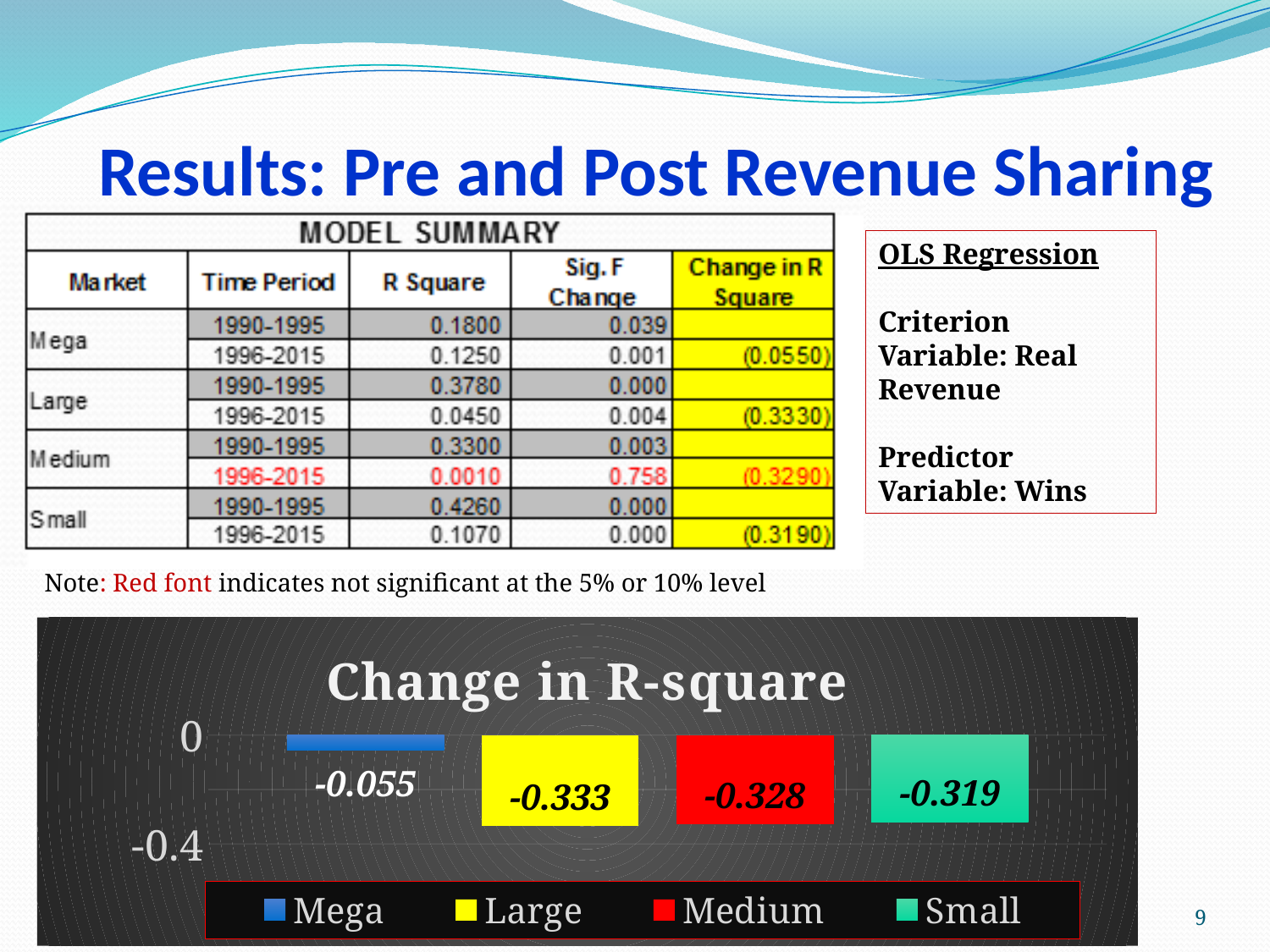
In the Change in R-square chart, which market has the lowest (most negative) value? Large In the Change in R-square chart, which market has the highest (least negative) value? Mega In the Change in R-square chart, what is the difference between the values for Large and Medium? 0.005 How many markets are plotted in the Change in R-square chart? 4 What is the value for Small in the Change in R-square chart? -0.319 In the Change in R-square chart, is the value for Large greater or less than -0.4? greater What is the value for Large in the Change in R-square chart? -0.333 In the Change in R-square chart, what is the difference between the values for Mega and Small? 0.264 What kind of chart is the Change in R-square chart? bar chart What is the value for Medium in the Change in R-square chart? -0.328 In the Change in R-square chart, which is larger, the value for Mega or the value for Large? Mega What is the value for Mega in the Change in R-square chart? -0.055